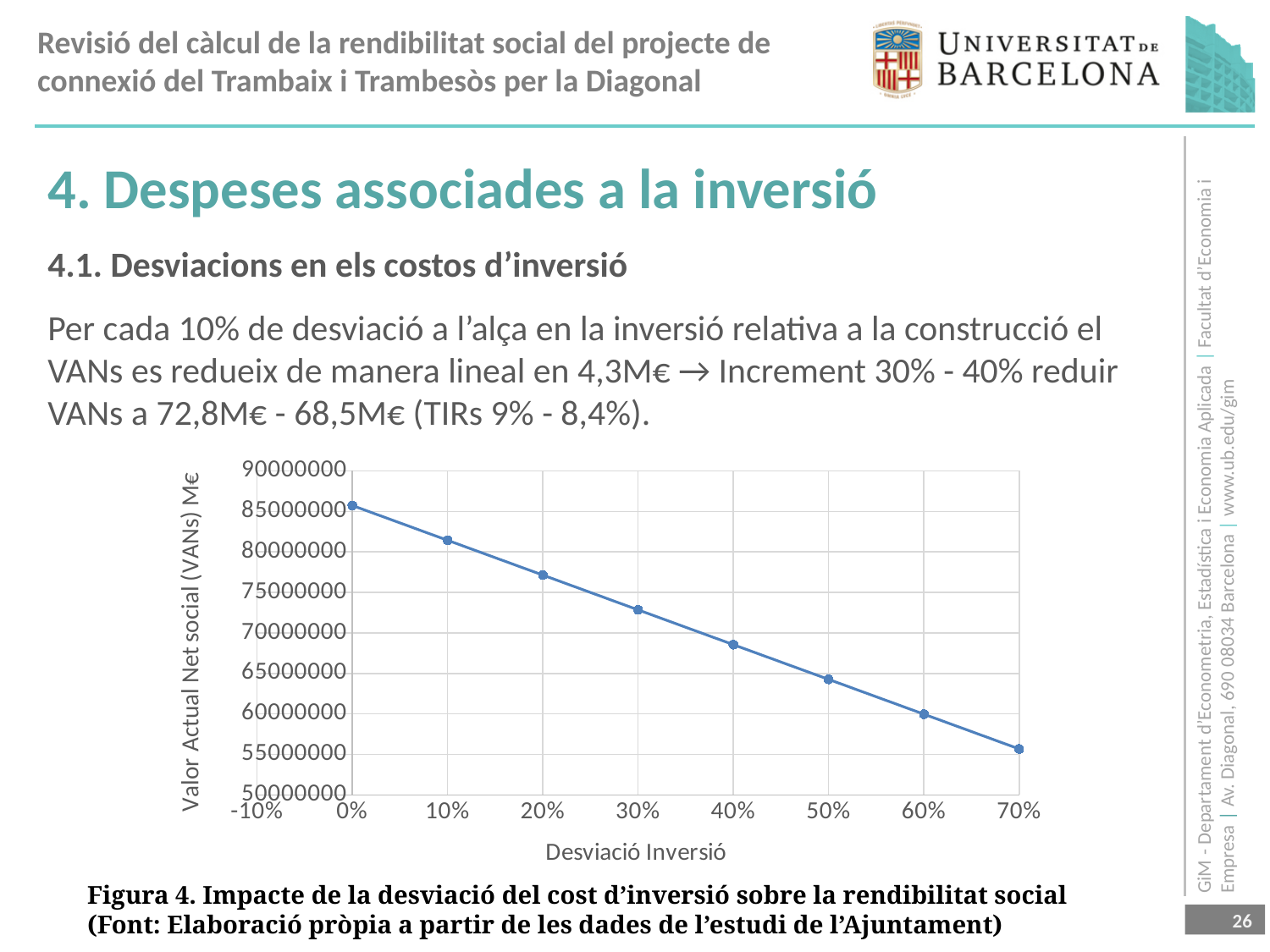
What kind of chart is shown on the slide? line chart What is the title of the horizontal axis? Desviació Inversió How many data points are plotted on the line? 8 At which Desviació Inversió value is the Valor Actual Net social lowest? 70% Which has a larger Valor Actual Net social: 30% or 50% Desviació Inversió? 30% Is the value at 20% Desviació Inversió greater or less than 75000000? greater What is the title of the vertical axis? Valor Actual Net social (VANs) M€ At which Desviació Inversió value is the Valor Actual Net social highest? 0% Is the value at 10% Desviació Inversió greater or less than 80000000? greater Is the value at 40% Desviació Inversió greater or less than 70000000? less Do the values rise or fall as Desviació Inversió increases from 0% to 70%? fall